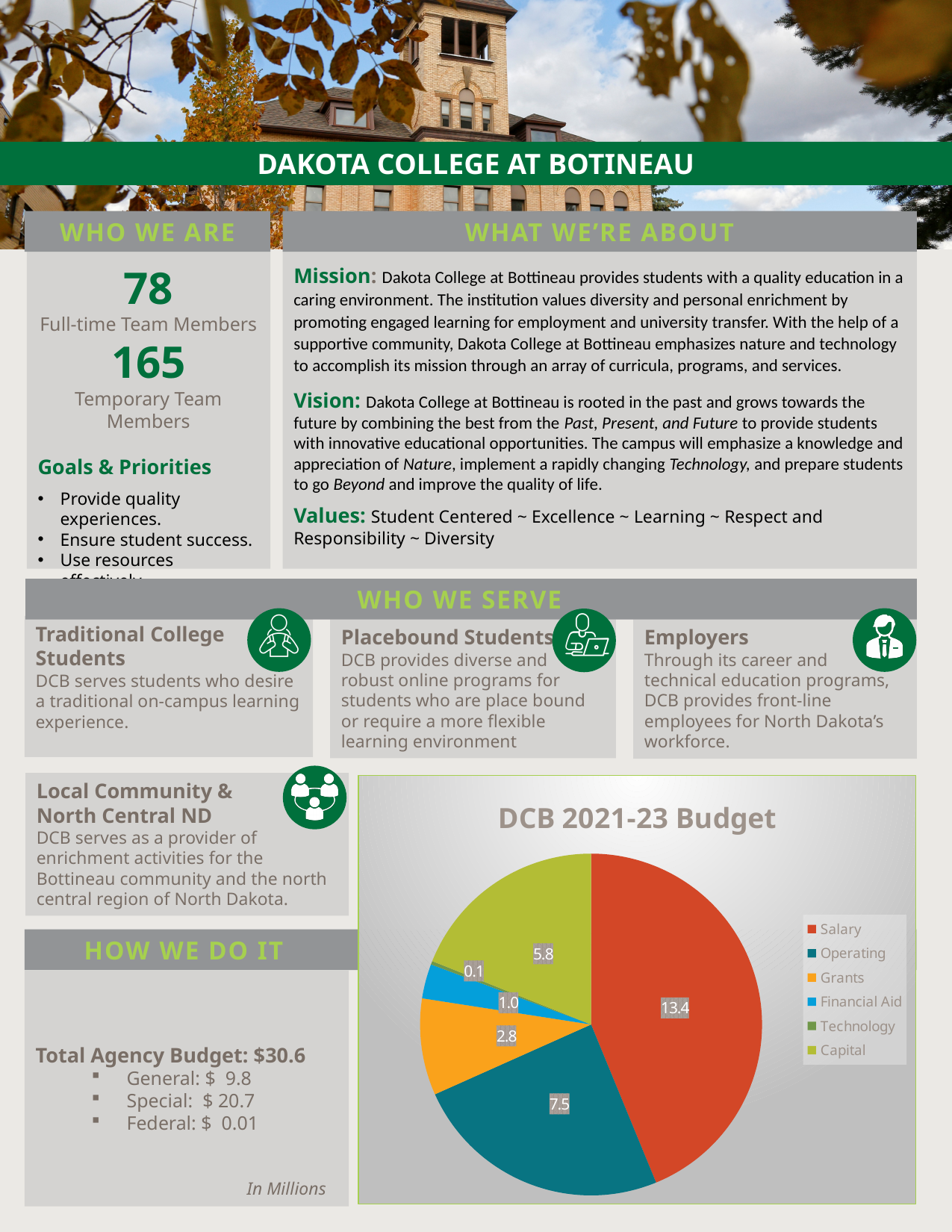
What is the sum of all the values labelled in the DCB 2021-23 Budget pie chart? 30.6 In the DCB 2021-23 Budget pie chart, what value is shown for Grants? 2.8 In the DCB 2021-23 Budget pie chart, what value is shown for Salary? 13.4 In the DCB 2021-23 Budget pie chart, what value is shown for Financial Aid? 1.0 In the DCB 2021-23 Budget pie chart, what value is shown for Operating? 7.5 In the DCB 2021-23 Budget pie chart, what is the difference between the Salary value and the Operating value? 5.9 In the DCB 2021-23 Budget pie chart, which is larger, Grants or Capital? Capital In the DCB 2021-23 Budget pie chart, what value is shown for Capital? 5.8 Which category has the smallest slice in the DCB 2021-23 Budget pie chart? Technology What kind of chart is the DCB 2021-23 Budget chart? Pie chart How many categories does the legend of the DCB 2021-23 Budget chart list? 6 Which category has the largest slice in the DCB 2021-23 Budget pie chart? Salary